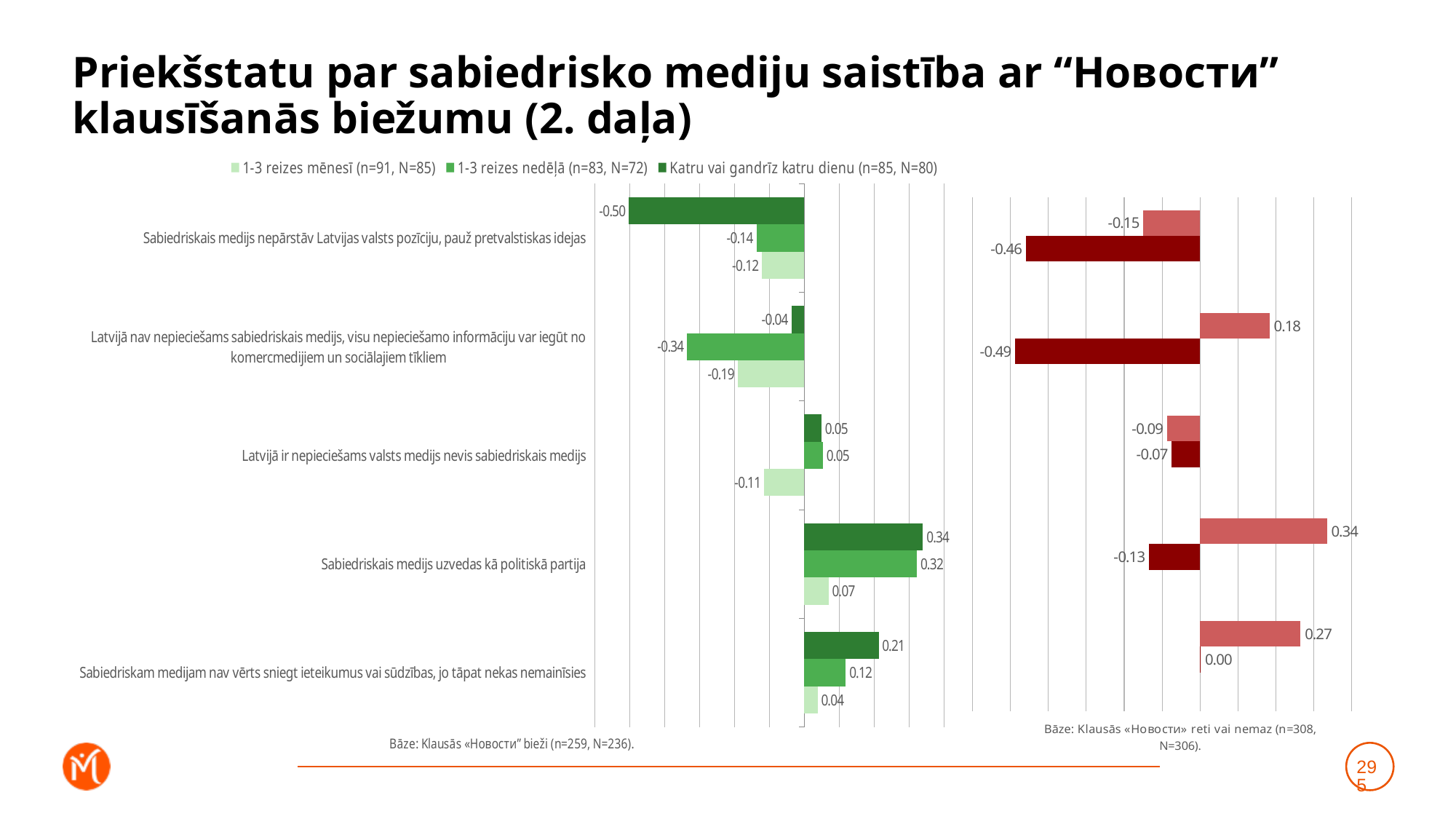
In the left chart, what is the value for '1-3 reizes nedēļā' for the statement 'Latvijā nav nepieciešams sabiedriskais medijs, visu nepieciešamo informāciju var iegūt no komercmedijiem un sociālajiem tīkliem'? -0.34 What kind of chart is shown on the left side of the slide? bar chart In the left chart, which statement has the highest value for the 'Katru vai gandrīz katru dienu' series? Sabiedriskais medijs uzvedas kā politiskā partija In the left chart, which statement has the lowest value for the '1-3 reizes mēnesī' series? Latvijā nav nepieciešams sabiedriskais medijs, visu nepieciešamo informāciju var iegūt no komercmedijiem un sociālajiem tīkliem In the right chart, what is the value of the dark red bar for the statement 'Latvijā nav nepieciešams sabiedriskais medijs, visu nepieciešamo informāciju var iegūt no komercmedijiem un sociālajiem tīkliem'? -0.49 How many statement categories are plotted in the left chart? 5 In the left chart, what is the value for '1-3 reizes mēnesī' for the statement 'Sabiedriskais medijs uzvedas kā politiskā partija'? 0.07 What base note is printed under the left chart? Bāze: Klausās «Новости» bieži (n=259, N=236). How many series does the legend of the left chart list? 3 In the left chart, for 'Sabiedriskais medijs uzvedas kā politiskā partija', which is larger: the 'Katru vai gandrīz katru dienu' value or the '1-3 reizes mēnesī' value? Katru vai gandrīz katru dienu In the left chart, what is the difference between the 'Katru vai gandrīz katru dienu' value (0.21) and the '1-3 reizes nedēļā' value (0.12) for 'Sabiedriskam medijam nav vērts sniegt ieteikumus vai sūdzības, jo tāpat nekas nemainīsies'? 0.09 In the left chart, what is the value for 'Katru vai gandrīz katru dienu' for the statement 'Sabiedriskais medijs nepārstāv Latvijas valsts pozīciju, pauž pretvalstiskas idejas'? -0.50